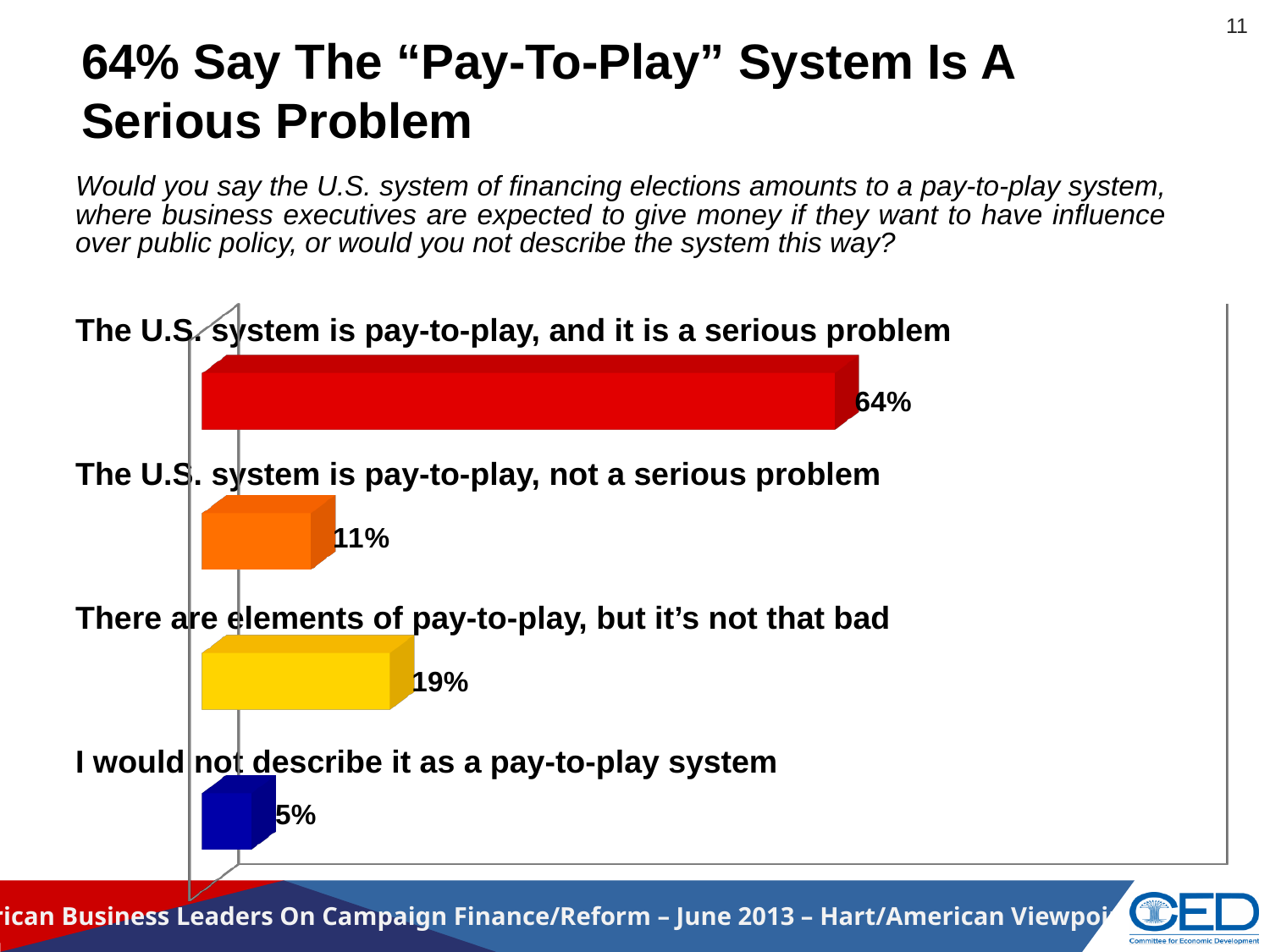
Which is larger: the percentage for 'There are elements of pay-to-play, but it's not that bad' or for 'The U.S. system is pay-to-play, not a serious problem'? There are elements of pay-to-play, but it's not that bad What is the combined percentage of the two responses that say the system is pay-to-play (serious problem and not a serious problem)? 75% What percentage of respondents say the U.S. system is pay-to-play, and it is a serious problem? 64% Which response has the lowest percentage? I would not describe it as a pay-to-play system What percentage of respondents say there are elements of pay-to-play, but it's not that bad? 19% What kind of chart is shown on the slide? Bar chart How many response categories are shown in the chart? 4 What percentage of respondents would not describe it as a pay-to-play system? 5% What is the difference in percentage points between 'The U.S. system is pay-to-play, and it is a serious problem' and 'There are elements of pay-to-play, but it's not that bad'? 45 percentage points What colour is the bar for 'The U.S. system is pay-to-play, and it is a serious problem'? Red What percentage of respondents say the U.S. system is pay-to-play, not a serious problem? 11% Which response has the highest percentage? The U.S. system is pay-to-play, and it is a serious problem